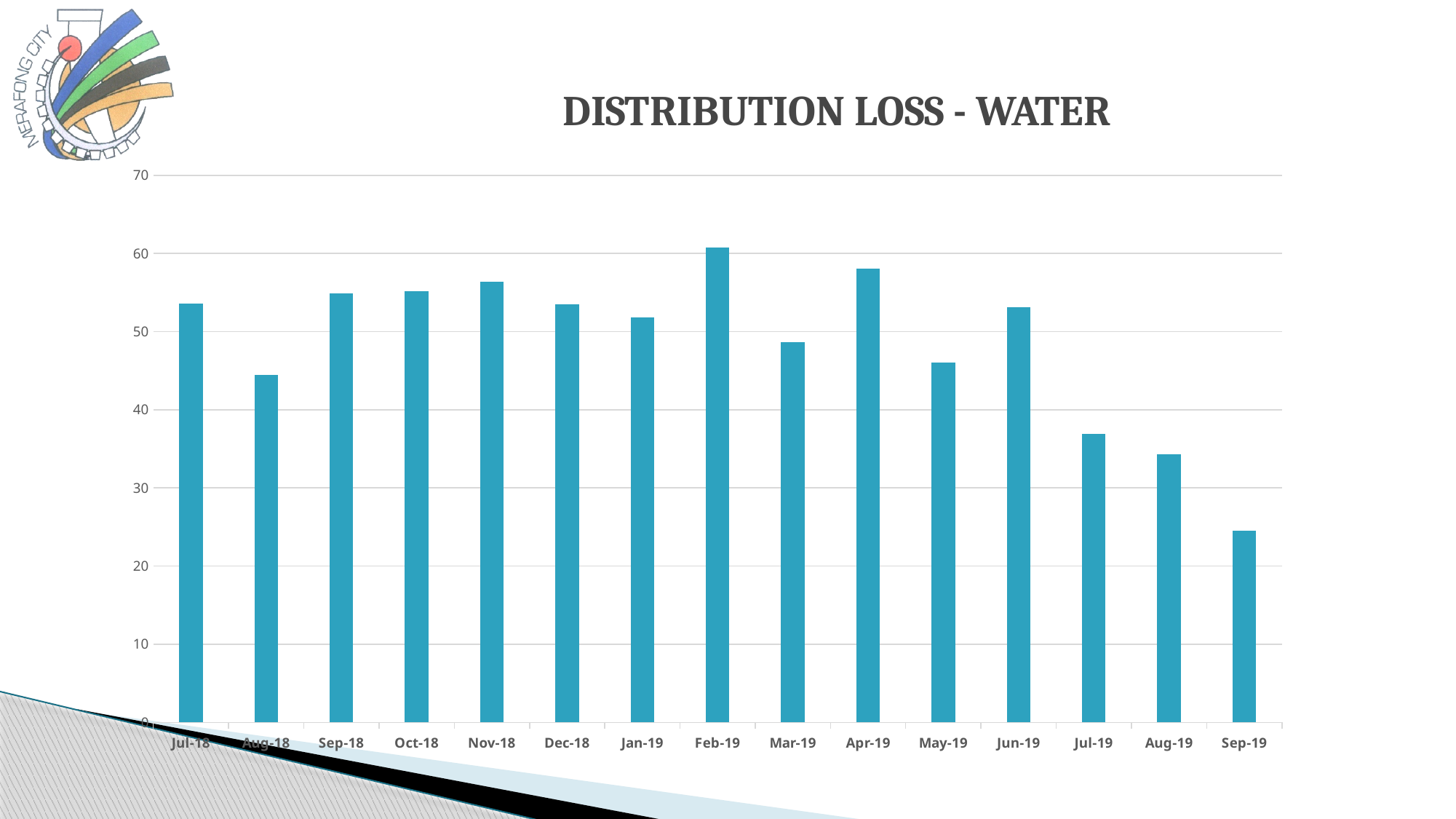
Which month has the lowest distribution loss? Sep-19 What is the title of the chart? DISTRIBUTION LOSS - WATER Is the value for Aug-18 greater or less than 40? greater Is the value for Jul-19 greater or less than 40? less Is the value for Sep-19 greater or less than 30? less Which is larger, the value for Nov-18 or the value for Aug-18? Nov-18 How many months are plotted on the x axis? 15 What type of chart is shown on the slide? Bar chart Which is larger, the value for Mar-19 or the value for Apr-19? Apr-19 Do the values rise or fall from Jun-19 to Sep-19? fall Which month has the highest distribution loss? Feb-19